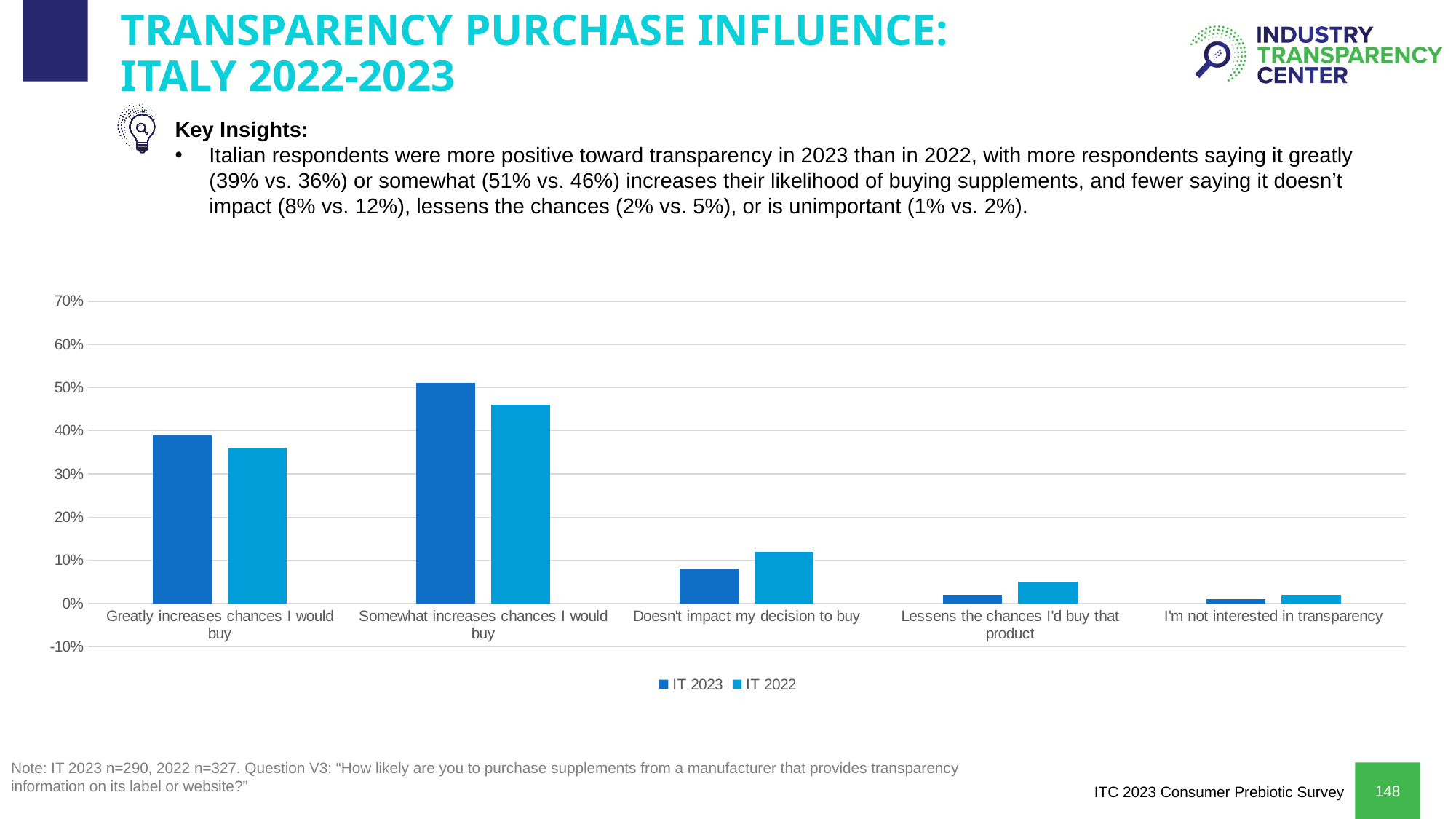
Which series is shown in the darker blue colour in the legend? IT 2023 For 'Doesn't impact my decision to buy', which series has the larger value, IT 2023 or IT 2022? IT 2022 Is the IT 2023 value for 'Somewhat increases chances I would buy' greater or less than 50%? greater Is the IT 2022 value for 'Greatly increases chances I would buy' greater or less than 40%? less How many series does the legend list? 2 According to the slide, what share of Italian respondents in 2023 said transparency somewhat increases their chances of buying? 51% What kind of chart is shown on the slide? Bar chart How many categories are shown on the x axis? 5 Which category has the lowest value for IT 2023? I'm not interested in transparency Which category has the highest value for IT 2023? Somewhat increases chances I would buy For 'Greatly increases chances I would buy', which series has the larger value, IT 2023 or IT 2022? IT 2023 According to the slide, what share of Italian respondents in 2022 said transparency doesn't impact their decision to buy? 12%